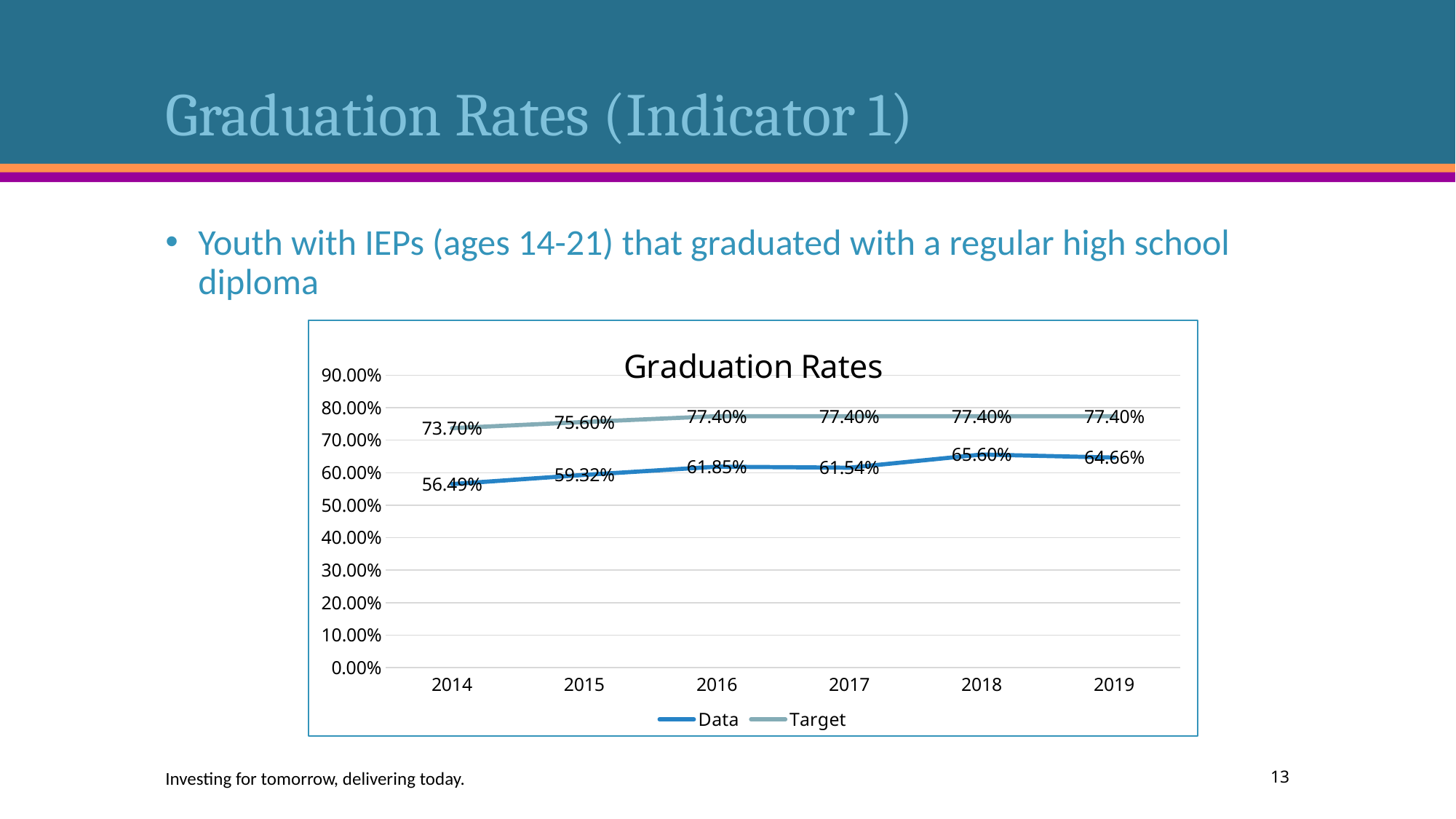
What is the Data value for 2018? 65.60% What is the Target value for 2015? 75.60% What kind of chart is shown? line chart How many years are shown on the x axis? 6 Which is larger, the Data value for 2016 or the Data value for 2017? 2016 In which year is the Data series highest? 2018 In which year is the Data series lowest? 2014 What is the Data value for 2014? 56.49% How many series does the legend list? 2 What is the difference between the Target and Data values in 2019? 12.74% What is the title of the chart? Graduation Rates Is the Data value for 2019 greater or less than 60.00%? greater